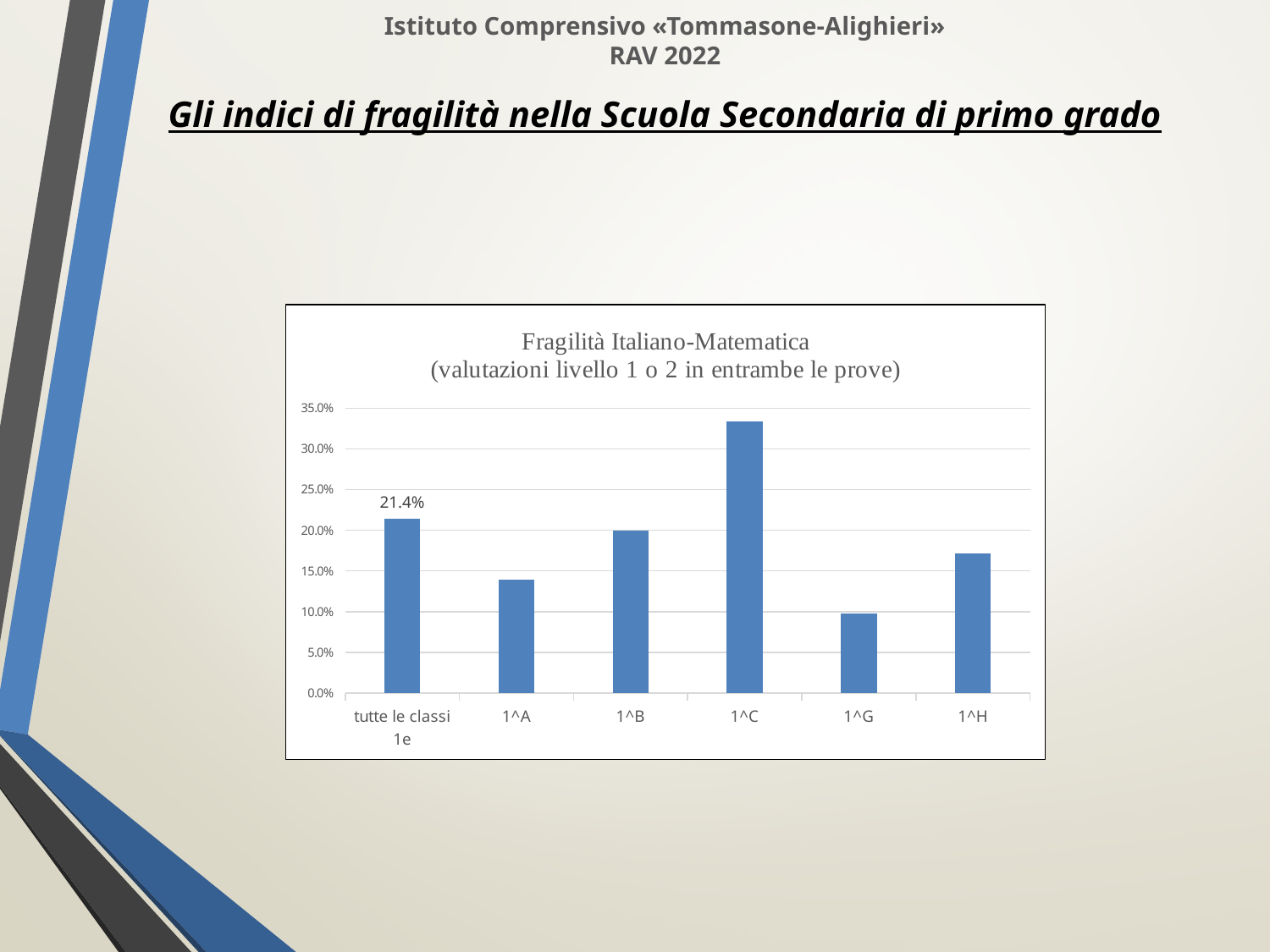
How many categories are shown on the x axis of the chart? 6 Is the value for 1^A greater or less than 20.0%? less What is the value for 'tutte le classi 1e' in the Fragilità Italiano-Matematica chart? 21.4% What kind of chart is shown on the slide? Bar chart Which category has the lowest value in the chart? 1^G Which has a larger value, 1^B or 1^A? 1^B Which category has the highest value in the chart? 1^C Is the value for 1^C greater or less than 30.0%? greater Is the value for 1^G greater or less than 15.0%? less What is the title of the chart? Fragilità Italiano-Matematica (valutazioni livello 1 o 2 in entrambe le prove) Which has a larger value, 1^H or 1^G? 1^H